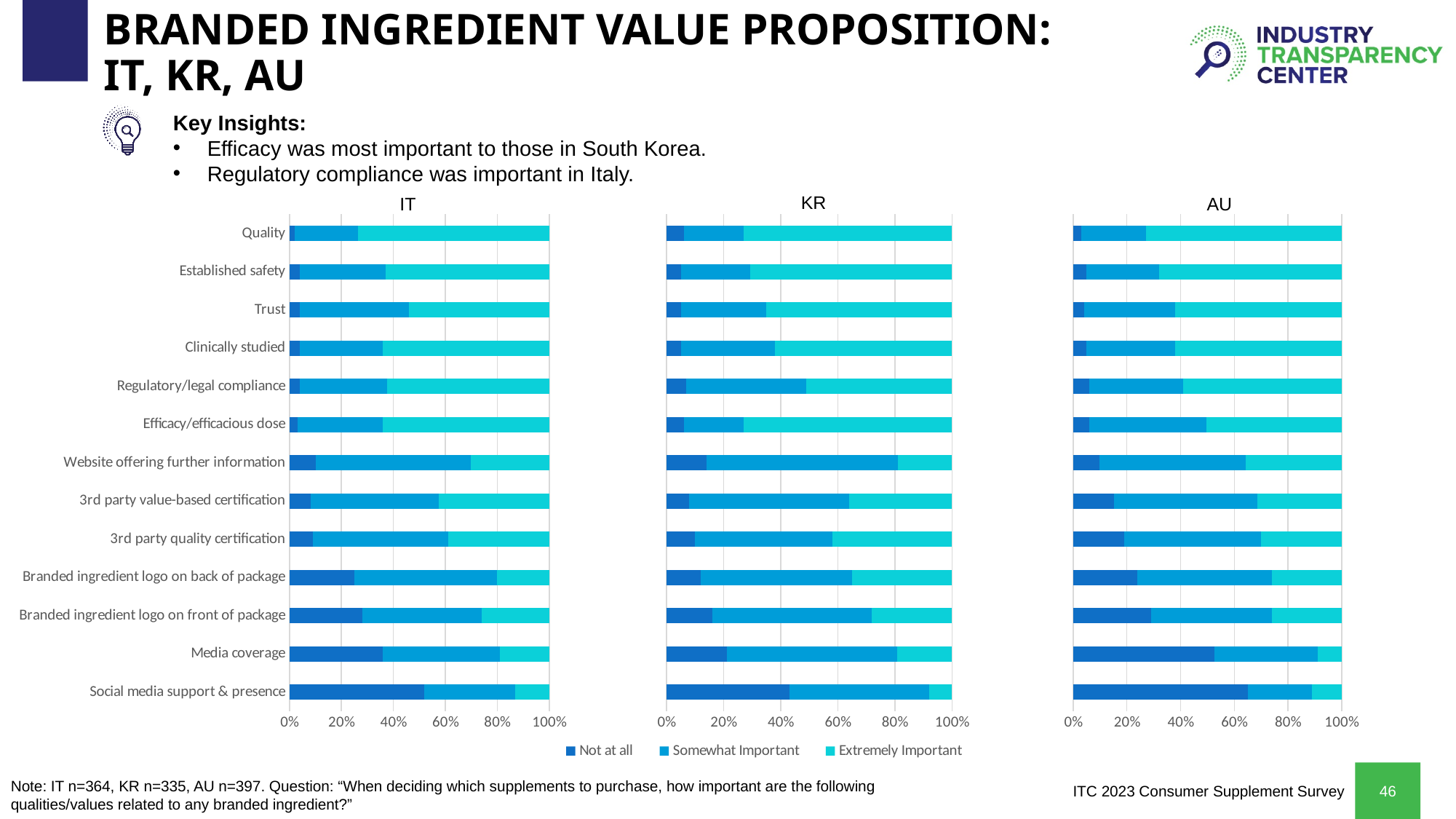
What are the three legend entries shown below the charts? Not at all, Somewhat Important, Extremely Important How many categories are plotted in the IT chart? 13 In the IT chart, which category has the largest 'Not at all' share? Social media support & presence What kind of chart is used for the IT, KR and AU panels on this slide? Stacked bar chart In the KR chart, is the 'Not at all' share for Quality greater or less than 20%? less In the IT chart, which category has the smallest 'Not at all' share? Quality In the AU chart, is the 'Not at all' share for Media coverage greater or less than 40%? greater In the IT chart, is the 'Not at all' share for Social media support & presence greater or less than 40%? greater In the AU chart, which category has the largest 'Not at all' share? Social media support & presence In the IT chart, is the 'Extremely Important' share larger for Quality or for Social media support & presence? Quality How many series does the legend list? 3 In the KR chart, is the 'Not at all' share larger for Media coverage or for Quality? Media coverage